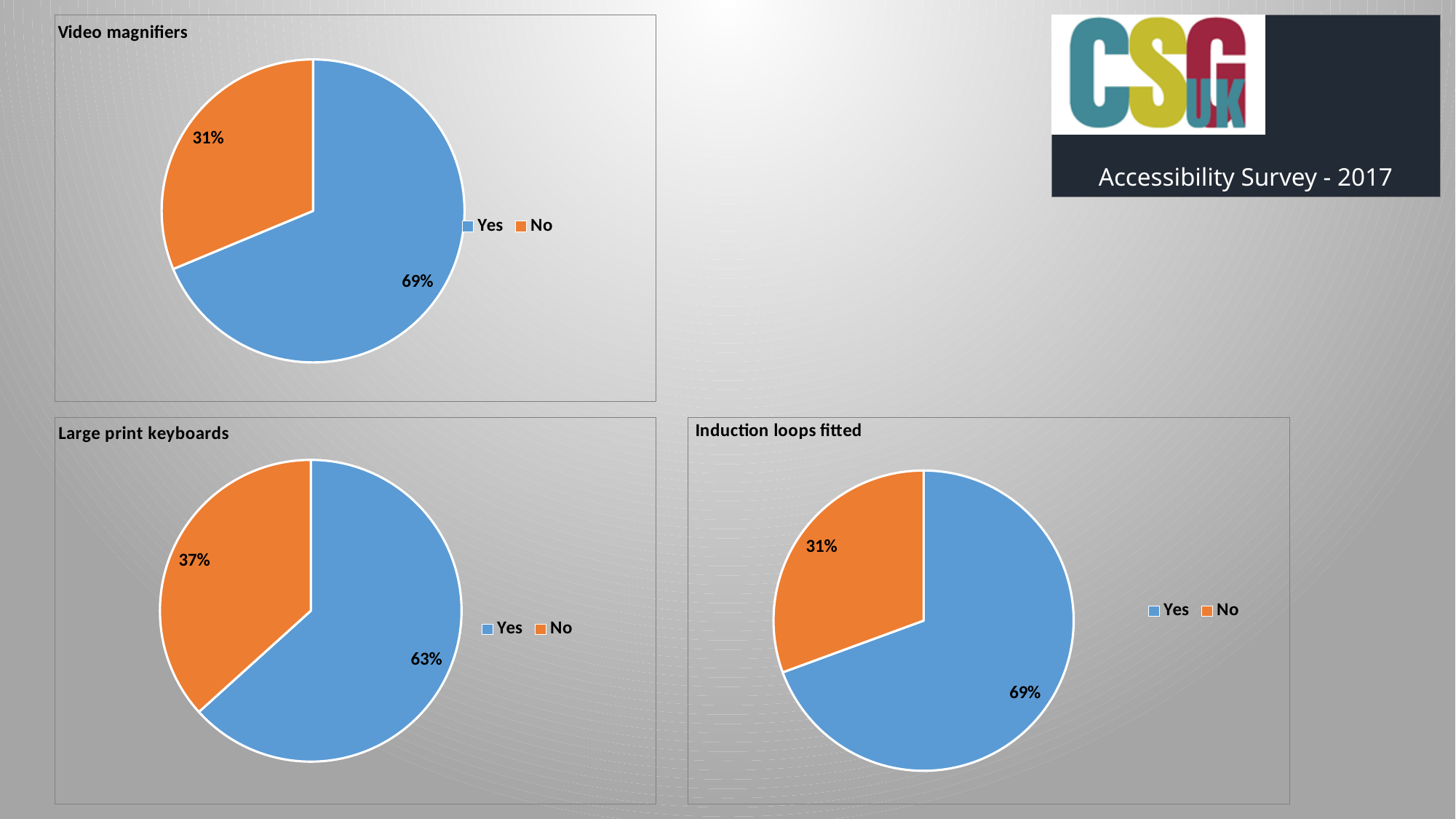
In the 'Large print keyboards' chart, what percentage is shown for No? 37% In the 'Large print keyboards' chart, what percentage is shown for Yes? 63% In the 'Induction loops fitted' chart, which slice is the largest? Yes How many entries does the legend of the 'Large print keyboards' chart list? 2 In the 'Induction loops fitted' chart, what percentage is shown for Yes? 69% What type of chart is the 'Induction loops fitted' chart? pie chart In the 'Video magnifiers' chart, what percentage is shown for No? 31% In the 'Large print keyboards' chart, what is the difference between the Yes and No percentages? 26% In the 'Video magnifiers' chart, what percentage is shown for Yes? 69% In the 'Video magnifiers' chart, what colour is the No slice? orange In the 'Large print keyboards' chart, which slice is the smallest? No In the 'Video magnifiers' chart, is the Yes slice larger or smaller than the No slice? larger